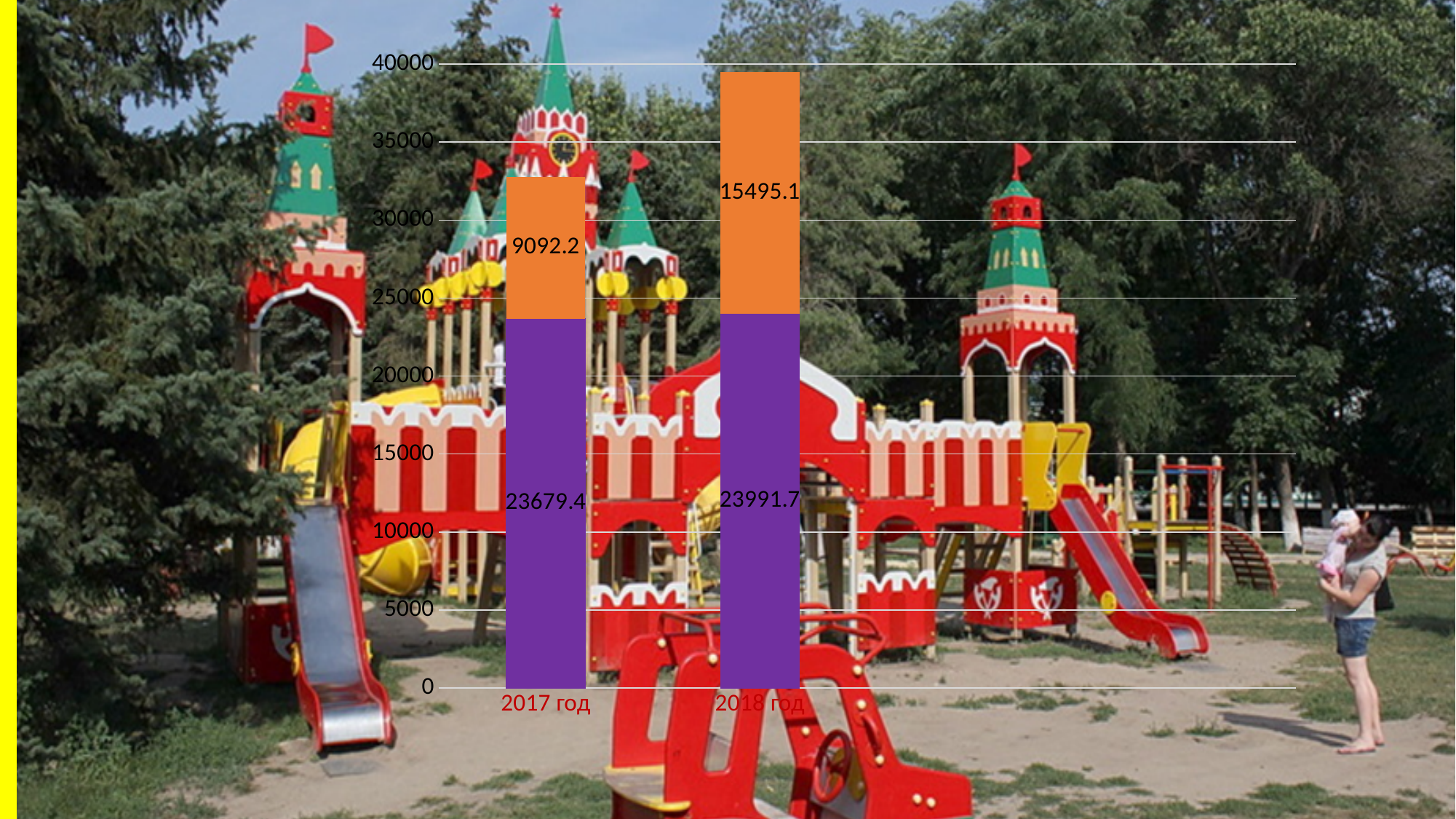
What is the total of the stacked bar for 2017 год? 32771.6 What is the total of the stacked bar for 2018 год? 39486.8 What is the value of the orange segment for 2017 год? 9092.2 What is the difference between the orange segment values for 2018 год and 2017 год? 6402.9 What is the value of the purple segment for 2017 год? 23679.4 How many categories are shown on the x axis? 2 What is the value of the orange segment for 2018 год? 15495.1 What kind of chart is shown on the slide? Stacked bar chart Which year has the larger orange segment, 2017 год or 2018 год? 2018 год What is the difference between the purple segment values for 2018 год and 2017 год? 312.3 What is the value of the purple segment for 2018 год? 23991.7 Is the total height of the 2018 год bar greater or less than 35000? greater